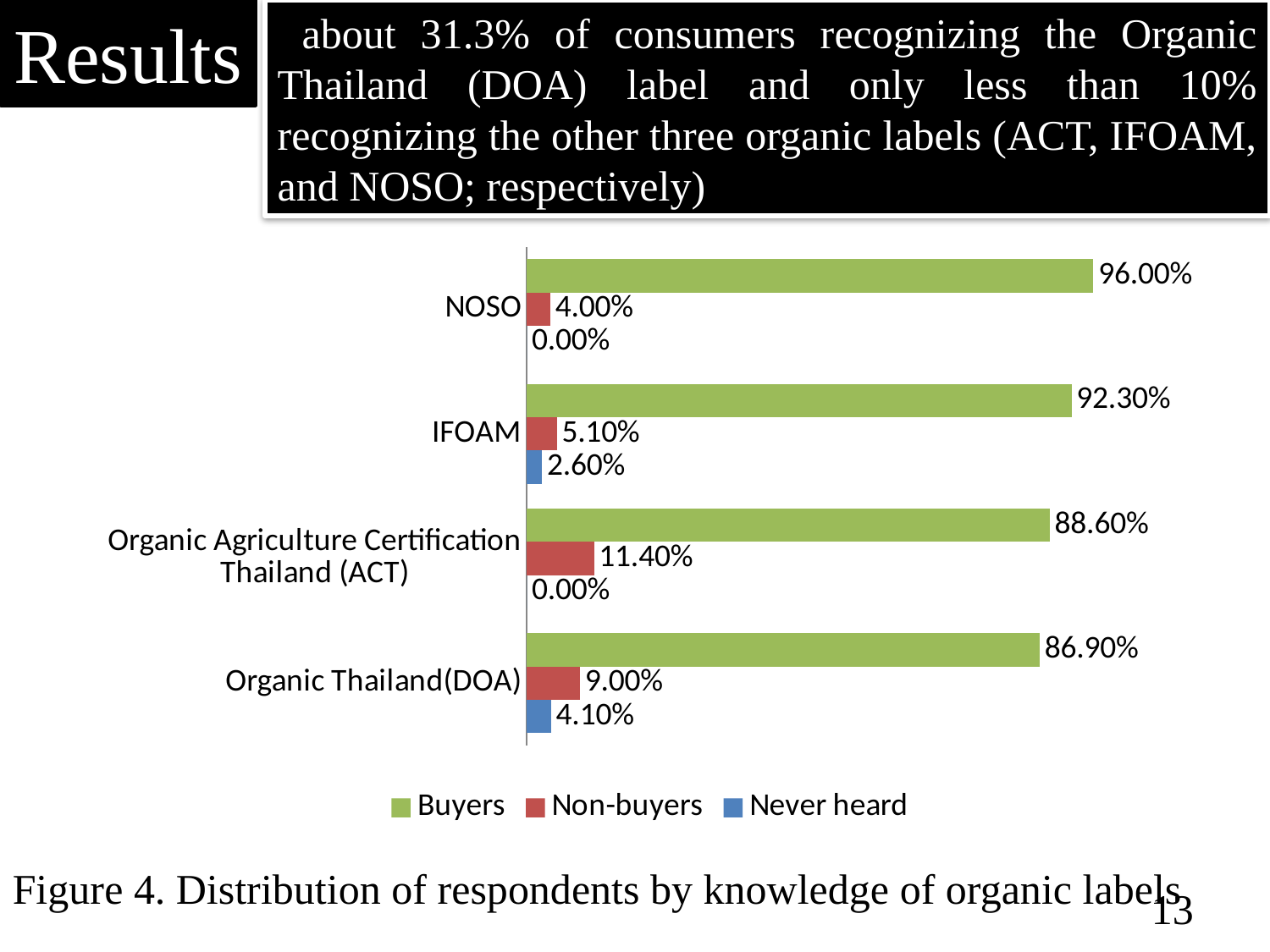
What is the Never heard value for Organic Thailand(DOA)? 4.10% How many organic labels are shown on the chart? 4 Which colour represents the Non-buyers series? Red What is the Never heard value for IFOAM? 2.60% What is the Non-buyers value for Organic Agriculture Certification Thailand (ACT)? 11.40% How many series does the legend list? 3 Which label has the highest Buyers value? NOSO What is the Buyers value for NOSO? 96.00% What kind of chart is shown on the slide? Bar chart Which label has the lowest Buyers value? Organic Thailand(DOA) What is the difference between the Buyers values for NOSO and Organic Thailand(DOA)? 9.10% Which is larger, the Non-buyers value for IFOAM or for Organic Thailand(DOA)? Organic Thailand(DOA)